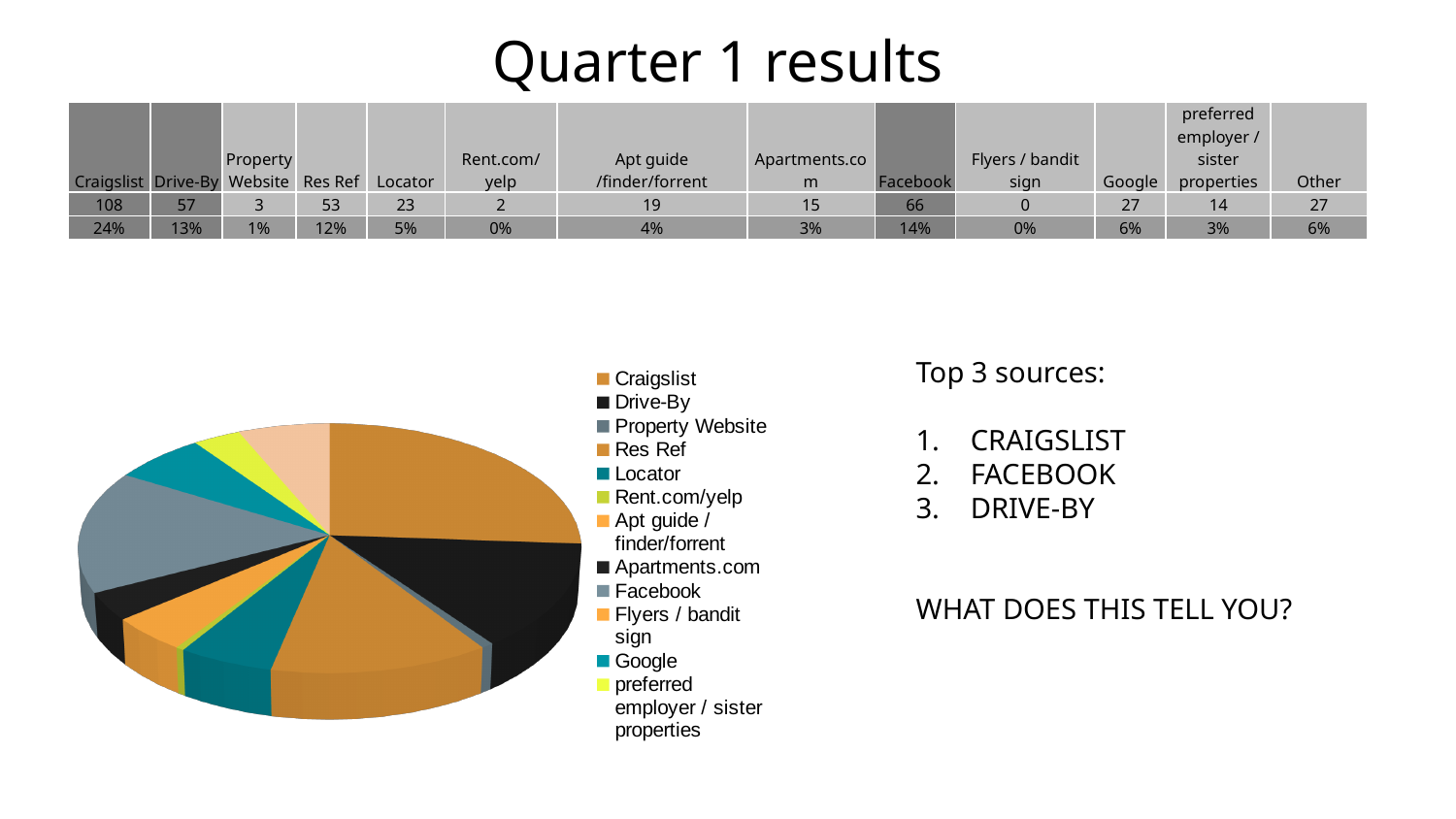
What is the value for Craigslist shown in the table? 108 How many entries does the pie chart's legend list? 12 What is the value for Facebook shown in the table? 66 Which is larger, the value for Facebook or the value for Drive-By? Facebook Which source has the largest slice of the pie chart? Craigslist What share of the pie does Craigslist represent, according to the table? 24% Which source has a value of 0 in the table? Flyers / bandit sign What percentage share does Drive-By have, according to the table? 13% What is the title of the slide containing the chart? Quarter 1 results What kind of chart is shown on the slide? pie chart What is the difference between the Craigslist value and the Facebook value in the table? 42 What is the value for Google shown in the table? 27